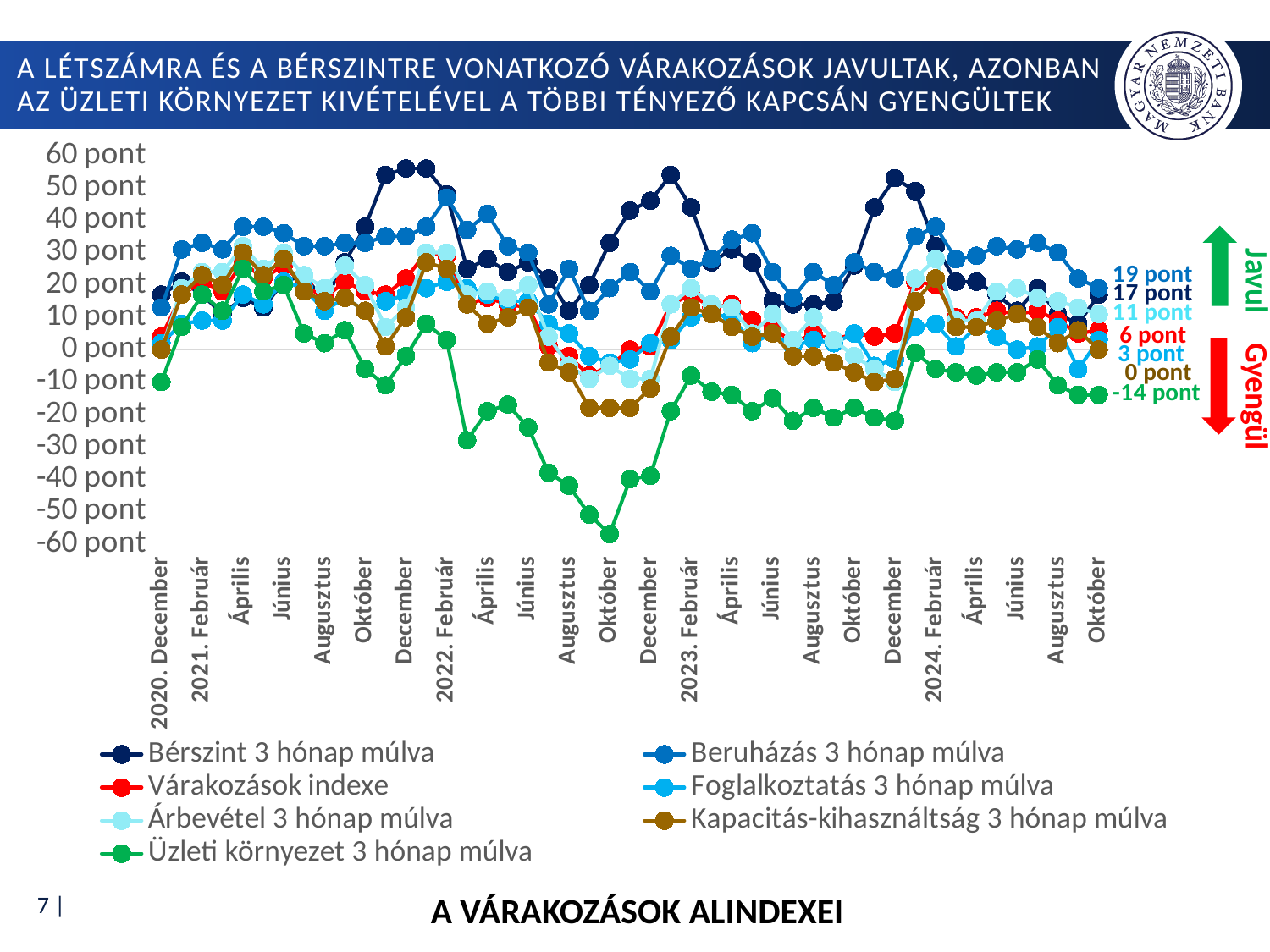
Which series has the highest value at the end of the chart? Beruházás 3 hónap múlva What is the latest value shown for Várakozások indexe? 6 pont How many series does the legend list? 7 Which series has the lowest value at the end of the chart? Üzleti környezet 3 hónap múlva What is the latest value shown for Kapacitás-kihasználtság 3 hónap múlva? 0 pont What is the latest value shown for Bérszint 3 hónap múlva? 17 pont What is the latest value shown for Beruházás 3 hónap múlva? 19 pont Is the value for Üzleti környezet 3 hónap múlva in Október 2022 greater or less than -50 pont? less What is the title of the chart at the bottom of the slide? A VÁRAKOZÁSOK ALINDEXEI What is the latest value shown for Üzleti környezet 3 hónap múlva? -14 pont What is the difference between the latest values of Beruházás 3 hónap múlva and Üzleti környezet 3 hónap múlva? 33 pont What kind of chart is shown on the slide? line chart